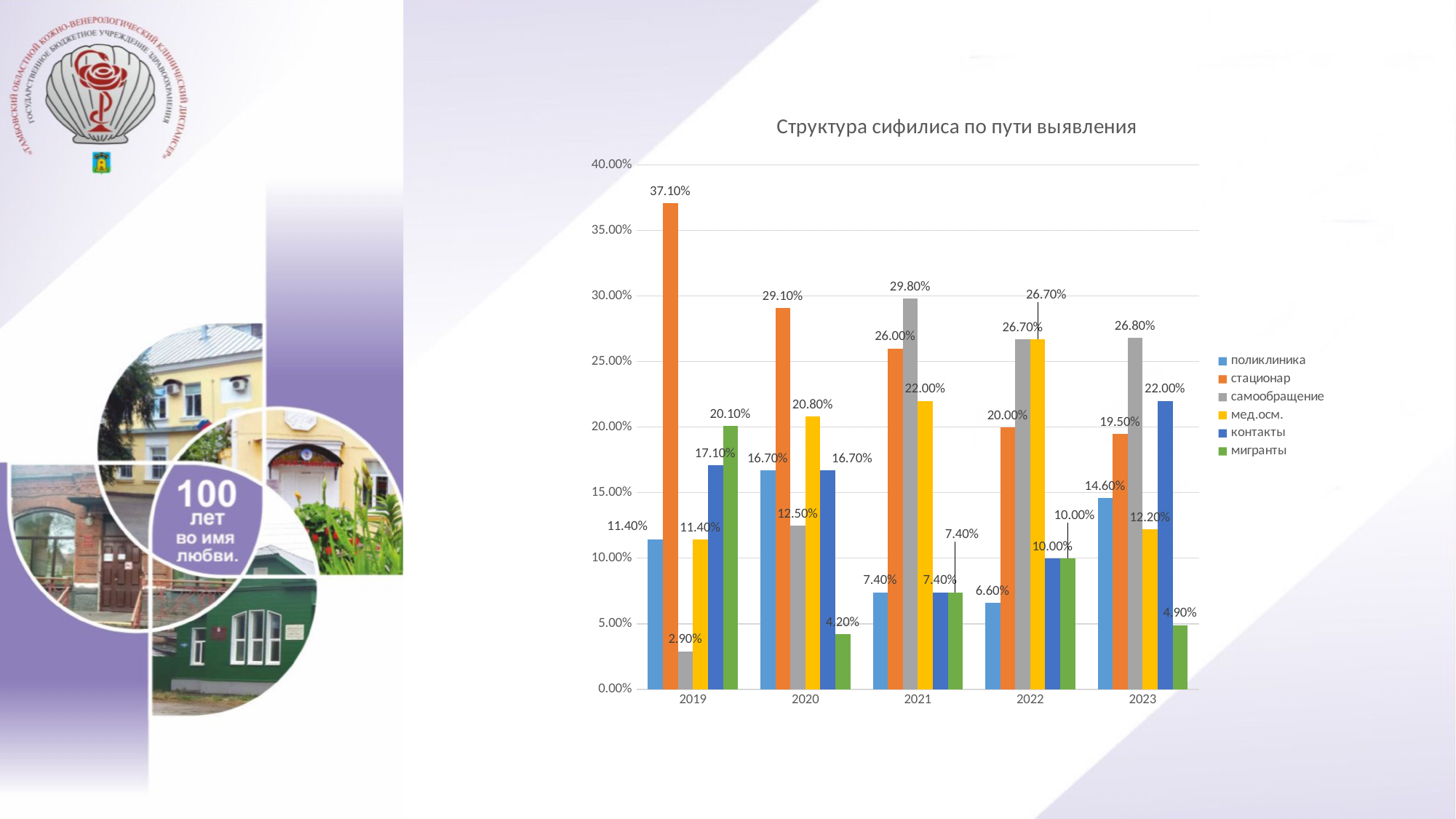
What is the difference between стационар in 2019 and стационар in 2020? 8.00% What kind of chart is shown? bar chart Which series has the highest value in 2019? стационар Does the value for стационар rise or fall from 2019 to 2023? fall How many series does the legend list? 6 Which series has the lowest value in 2020? мигранты What is the value for мед.осм. in 2020? 20.80% What is the value for стационар in 2019? 37.10% How many years are shown on the x axis? 5 Which is larger in 2023: поликлиника or стационар? стационар What is the value for контакты in 2023? 22.00% What is the value for самообращение in 2021? 29.80%